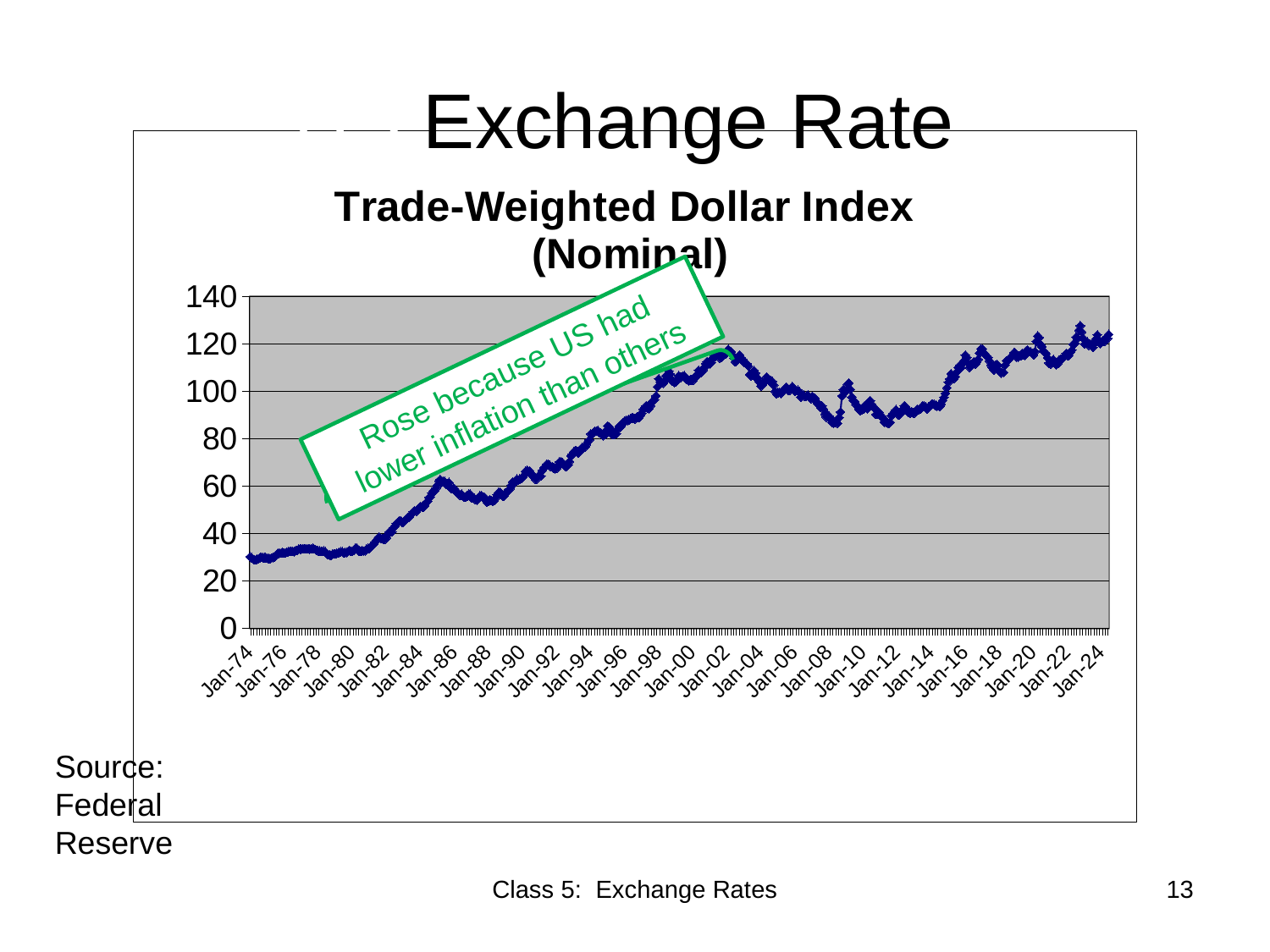
What kind of chart is shown on the slide? line chart What is the title of the chart? Trade-Weighted Dollar Index (Nominal) Is the value for Jan-80 greater or less than 40? less Is the value for Jan-24 greater or less than 100? greater Is the value for Jan-02 greater or less than 100? greater Overall, does the index rise or fall from Jan-74 to Jan-24? rise Which is larger, the value for Jan-02 or the value for Jan-10? Jan-02 What is the highest value shown on the chart's vertical axis? 140 Which is larger, the value for Jan-74 or the value for Jan-24? Jan-24